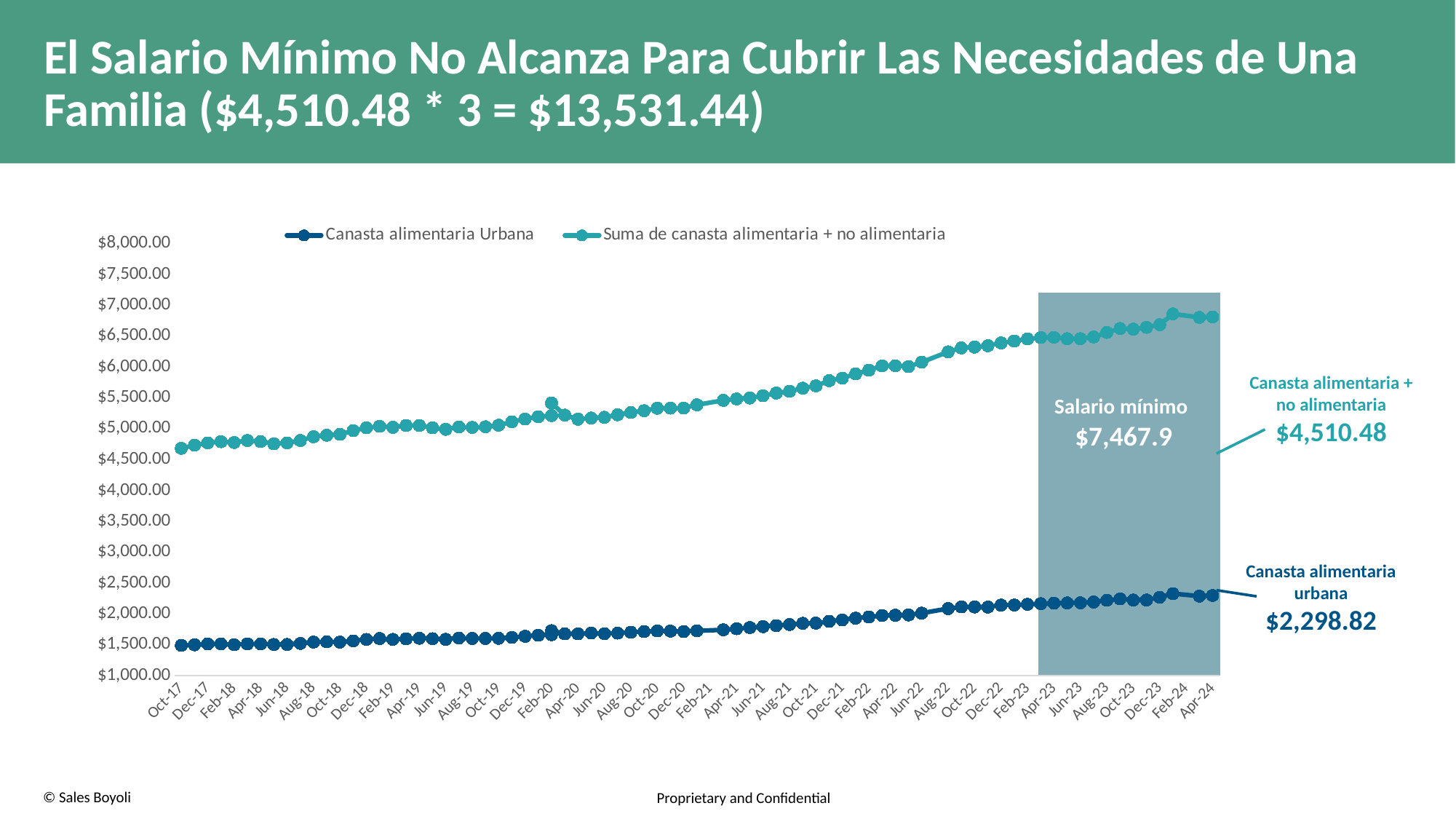
Is the value of Canasta alimentaria Urbana at Oct-17 greater or less than $2,000.00? less Is the value of Suma de canasta alimentaria + no alimentaria at Oct-17 greater or less than $5,000.00? less Which series has higher values across the whole period, Canasta alimentaria Urbana or Suma de canasta alimentaria + no alimentaria? Suma de canasta alimentaria + no alimentaria What is the difference between the labelled values for Canasta alimentaria + no alimentaria ($4,510.48) and Canasta alimentaria urbana ($2,298.82)? $2,211.66 What value is labelled for Canasta alimentaria urbana at the end of the line? $2,298.82 What are the two series named in the chart legend? Canasta alimentaria Urbana; Suma de canasta alimentaria + no alimentaria What value is labelled for Canasta alimentaria + no alimentaria at the end of the line? $4,510.48 What Salario mínimo value is shown in the shaded region of the chart? $7,467.9 Does the Canasta alimentaria Urbana line rise or fall from Oct-17 to Apr-24? rise What type of chart is shown on the slide? line chart How many series does the chart legend list? 2